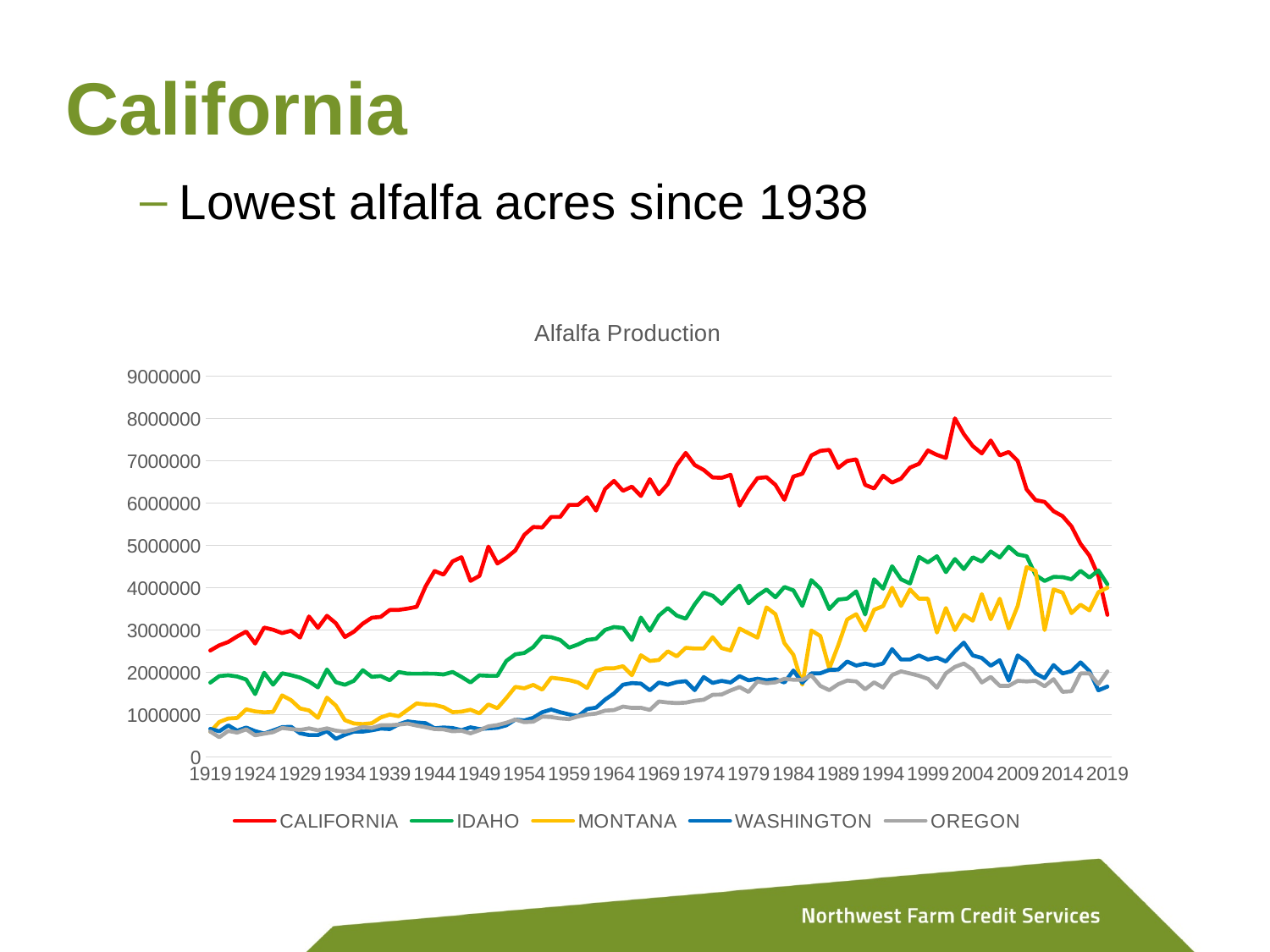
Is the value for WASHINGTON in 2019 greater or less than 2000000? less Is the value for MONTANA in 1919 greater or less than 1000000? less Is the value for CALIFORNIA in 1919 greater or less than 2000000? greater What kind of chart is shown on the slide? Line chart How many series does the chart's legend list? 5 What is the title of the chart? Alfalfa Production In 2009, which series has the larger value, MONTANA or OREGON? MONTANA Which series has the lowest alfalfa production in 2019? WASHINGTON Does the CALIFORNIA line rise or fall between 2004 and 2019? Falls In 1989, which series has the larger value, CALIFORNIA or IDAHO? CALIFORNIA Which series has the highest alfalfa production in 1999? CALIFORNIA